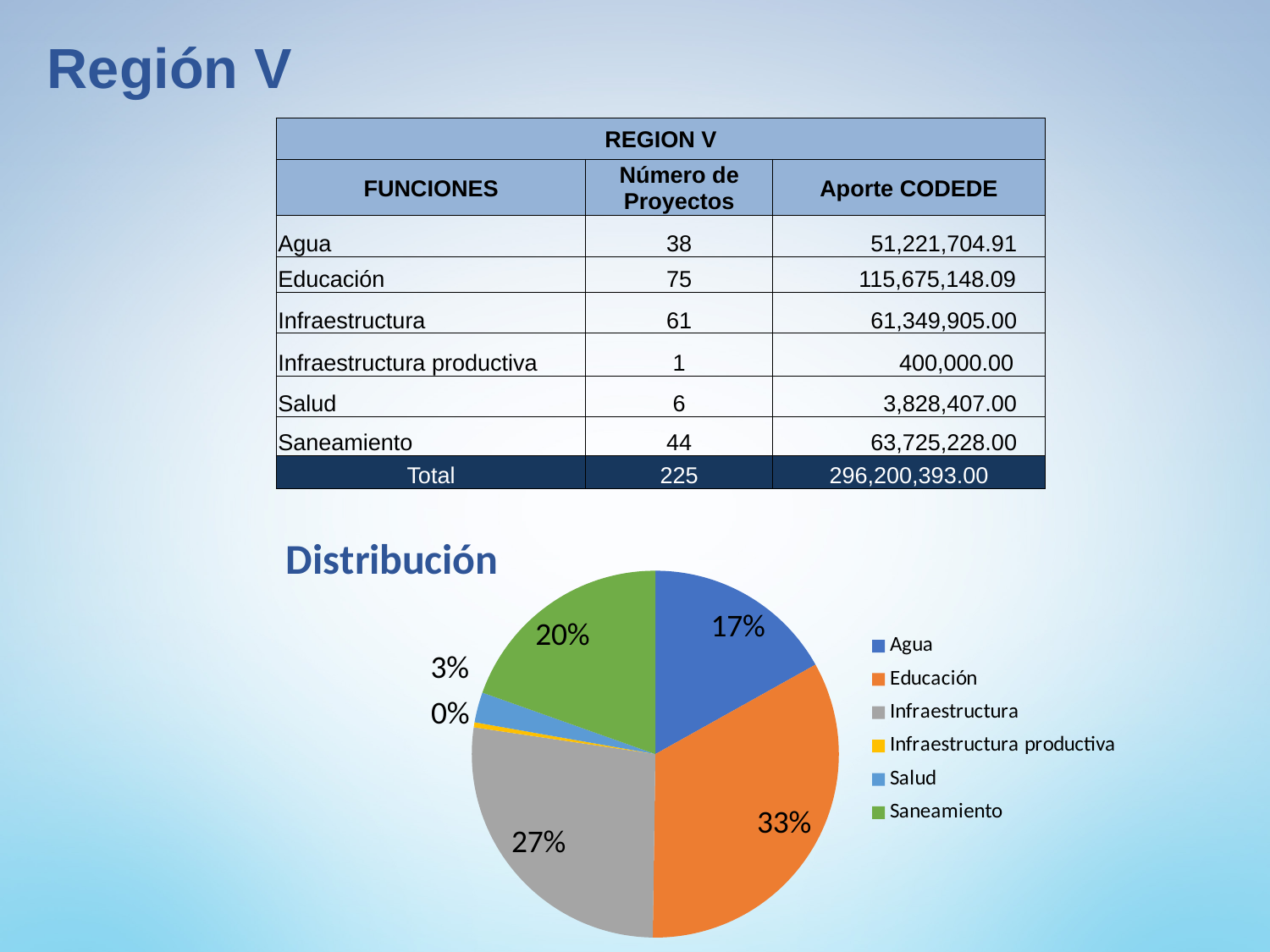
In the "Distribución" pie chart, what percentage is shown for Agua? 17% In the "Distribución" pie chart, what percentage is shown for Saneamiento? 20% What kind of chart is shown under the title "Distribución"? pie chart Which category has the smallest slice in the "Distribución" pie chart? Infraestructura productiva In the "Distribución" pie chart, which slice is larger, Agua or Saneamiento? Saneamiento In the "Distribución" pie chart, what percentage is shown for Infraestructura productiva? 0% In the "Distribución" pie chart, what percentage is shown for Educación? 33% In the "Distribución" pie chart, which category is shown in orange? Educación In the "Distribución" pie chart, what is the difference in percentage points between Educación and Infraestructura? 6 In the "Distribución" pie chart, what percentage is shown for Salud? 3% How many categories does the legend of the "Distribución" pie chart list? 6 Which category has the largest slice in the "Distribución" pie chart? Educación